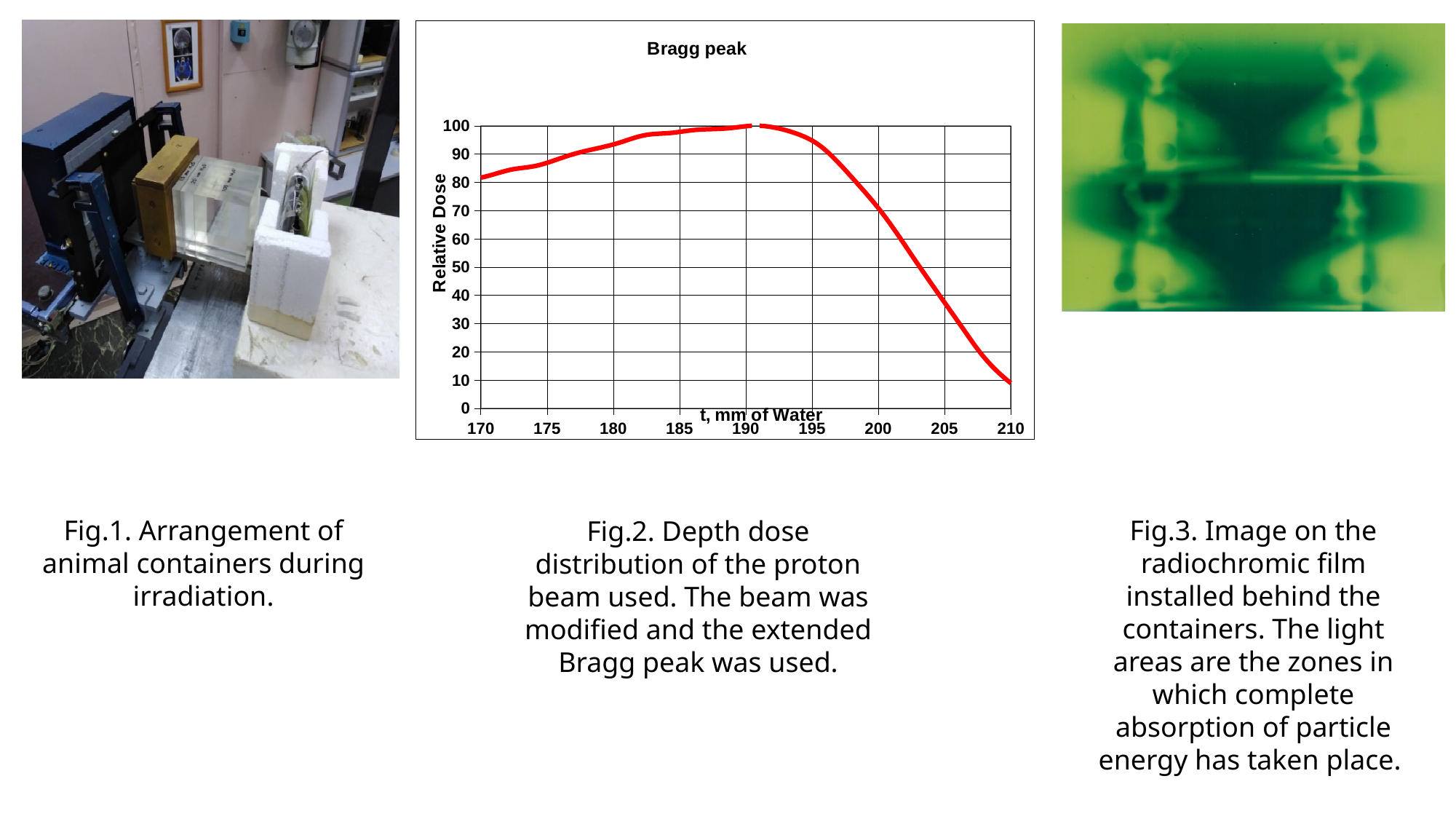
In the Bragg peak chart, which has the larger relative dose: 175 mm of water or 205 mm of water? 175 mm of water How many labelled tick marks are on the x axis of the Bragg peak chart? 9 In the Bragg peak chart, does the relative dose rise or fall between 195 and 210 mm of water? fall In the Bragg peak chart, does the relative dose rise or fall between 170 and 190 mm of water? rise In the Bragg peak chart, is the relative dose at 210 mm of water greater or less than 20? less In the Bragg peak chart, is the relative dose at 170 mm of water greater or less than 70? greater In the Bragg peak chart, what is the maximum relative dose reached by the curve? 100 What kind of chart is the Bragg peak chart? line chart In the Bragg peak chart, is the relative dose at 205 mm of water greater or less than 50? less What is the label of the y axis of the Bragg peak chart? Relative Dose What is the title of the chart on the slide? Bragg peak